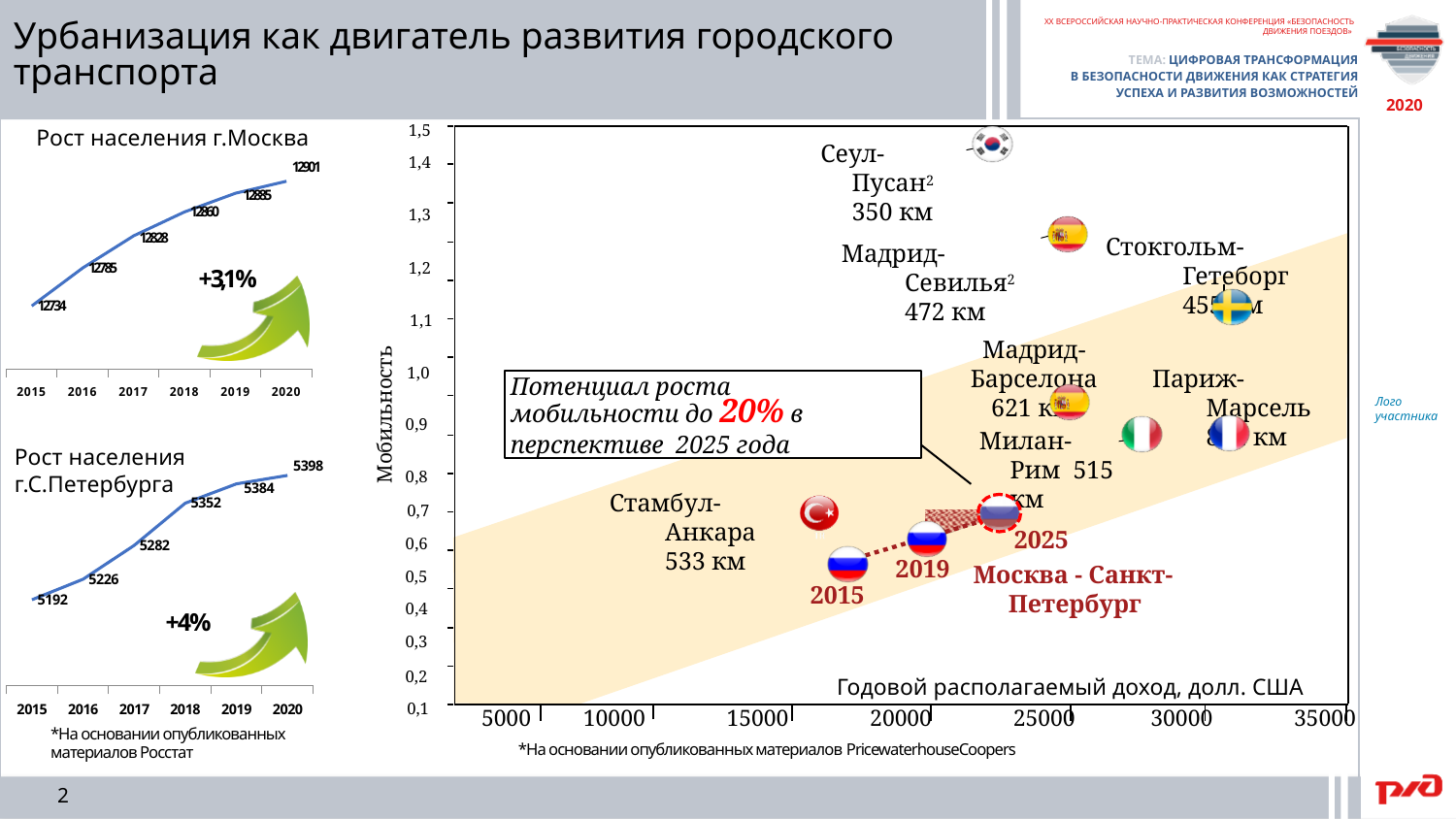
On the large chart on the right, is the mobility value for Москва - Санкт-Петербург in 2015 greater or less than 0,7? less On the chart 'Рост населения г.С.Петербурга', do the values rise or fall from 2015 to 2020? rise On the large chart on the right, what is the label of the y axis? Мобильность On the chart 'Рост населения г.Москва', what percentage growth is printed on the chart? +3,1% On the chart 'Рост населения г.Москва', by how much did the value change from 2015 to 2020? 167 On the chart 'Рост населения г.С.Петербурга', what is the difference between the 2020 and 2019 values? 14 On the chart 'Рост населения г.Москва', what is the value for 2020? 12901 What type of chart is 'Рост населения г.Москва'? line chart On the chart 'Рост населения г.С.Петербурга', how many years are plotted on the x axis? 6 On the chart 'Рост населения г.С.Петербурга', which year has the lowest value? 2015 On the chart 'Рост населения г.Москва', what is the value for 2015? 12734 On the chart 'Рост населения г.С.Петербурга', what is the value for 2018? 5352